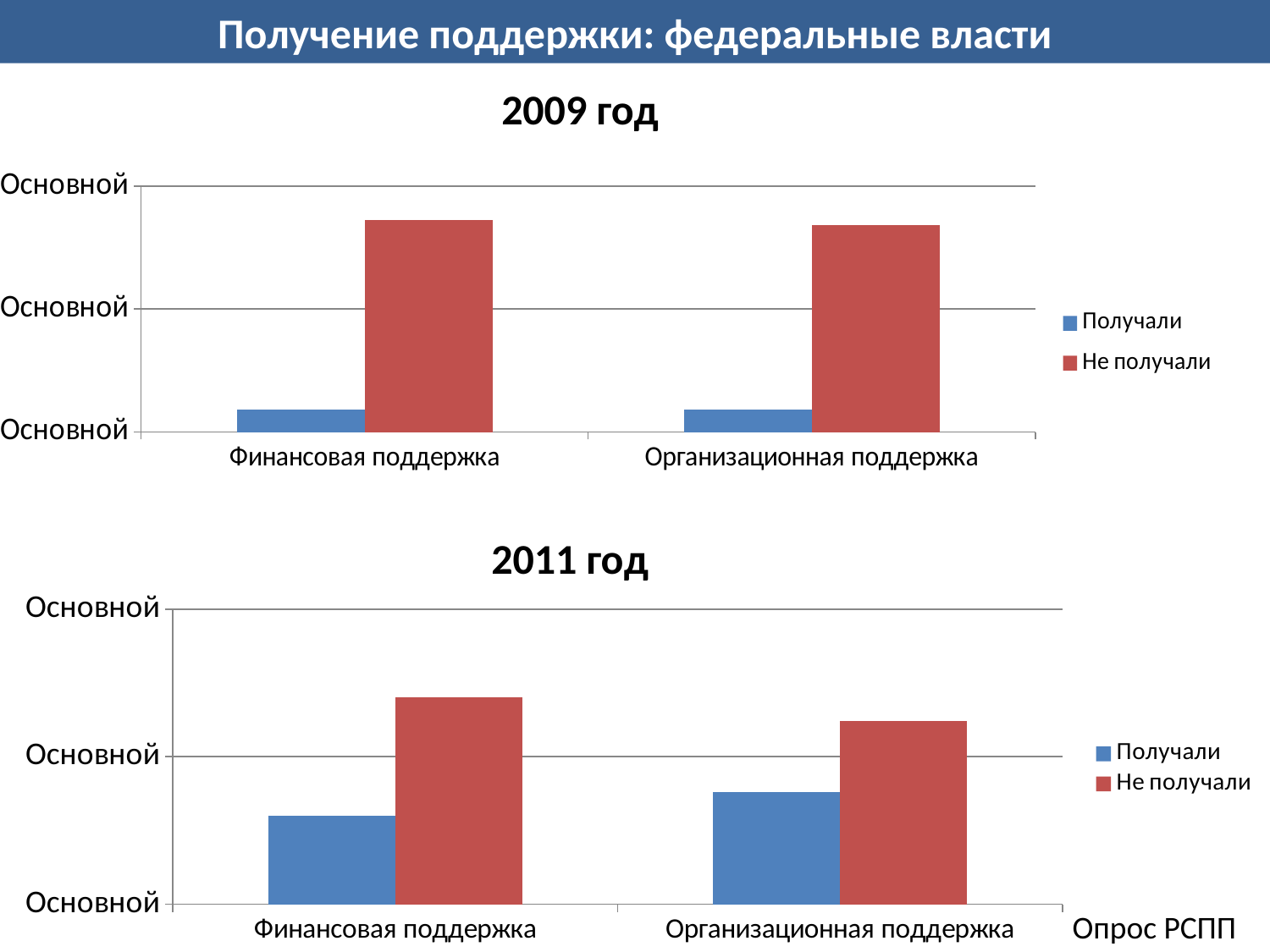
What are the two legend entries of the "2009 год" chart? Получали, Не получали What kind of chart is the "2011 год" chart? bar chart In the "2011 год" chart, which bar is the tallest? Не получали for Финансовая поддержка How many series does the legend of the "2011 год" chart list? 2 How many categories are shown on the x axis of the "2009 год" chart? 2 What kind of chart is the "2009 год" chart? bar chart In the "2009 год" chart, which is larger for Организационная поддержка: Получали or Не получали? Не получали In the "2011 год" chart, which category has the higher Получали value? Организационная поддержка In the "2011 год" chart, which bar is the shortest? Получали for Финансовая поддержка In the "2009 год" chart, which is larger for Финансовая поддержка: Получали or Не получали? Не получали What colour are the Не получали bars in the "2011 год" chart? red